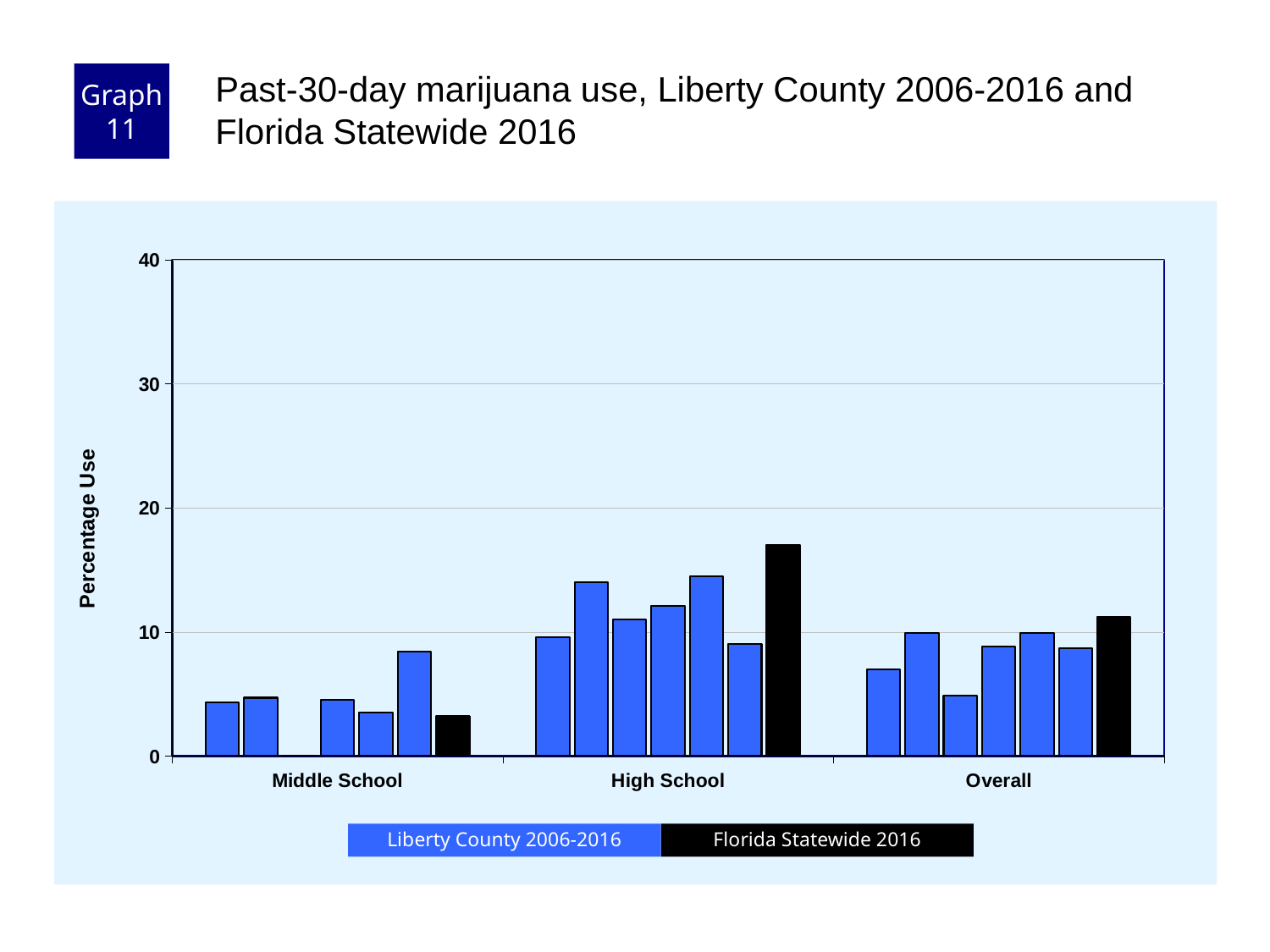
What is the label of the y axis? Percentage Use What are the two series named in the legend? Liberty County 2006-2016 and Florida Statewide 2016 Is the Florida Statewide 2016 value for Overall greater or less than 20? less Which category has the highest Florida Statewide 2016 value? High School Is the Florida Statewide 2016 value for Middle School greater or less than 10? less In which category does the tallest bar on the chart appear? High School What kind of chart is shown on the slide? bar chart Is the Florida Statewide 2016 value for High School greater or less than 10? greater Which is larger, the Florida Statewide 2016 value for High School or for Overall? High School How many categories are shown on the x axis? 3 Which category has the lowest Florida Statewide 2016 value? Middle School How many series does the legend list? 2